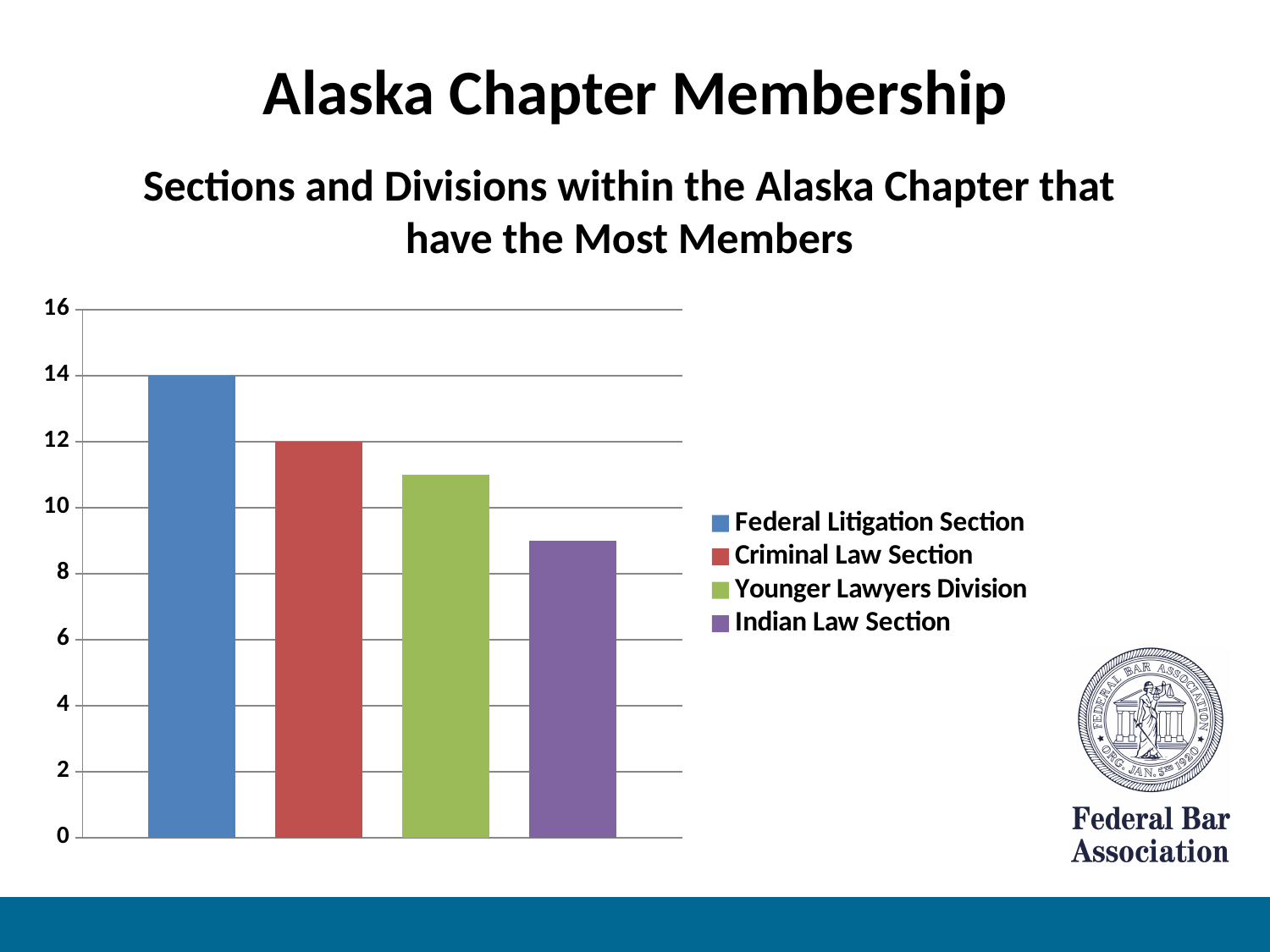
Is the value for Younger Lawyers Division greater or less than 10? greater What kind of chart is shown on the slide? Bar chart Which section or division has the lowest value? Indian Law Section Do the bar values rise or fall from left to right? Fall What is the difference between the values for Federal Litigation Section and Criminal Law Section? 2 Is the value for Indian Law Section greater or less than 10? less Which section or division has the highest value? Federal Litigation Section How many bars are plotted in the chart? 4 What is the value for Criminal Law Section? 12 Which is larger, the value for Federal Litigation Section or the value for Indian Law Section? Federal Litigation Section How many entries does the legend list? 4 What is the value for Federal Litigation Section? 14